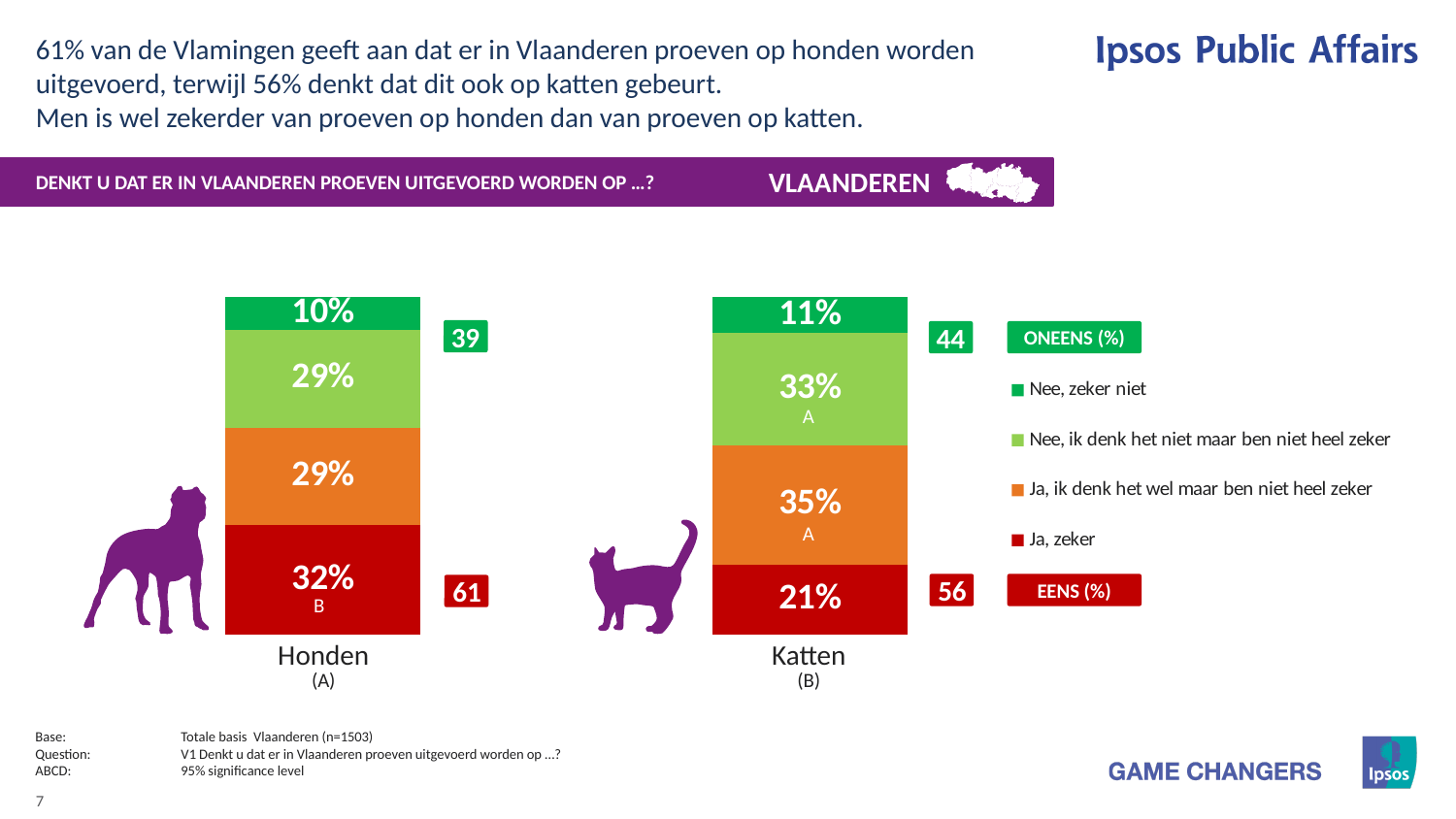
How many series does the legend list? 4 What kind of chart is shown on the slide? Stacked bar chart What is the combined 'ONEENS (%)' total shown for Katten? 44 What is the value of 'Ja, ik denk het wel maar ben niet heel zeker' for Katten? 35% What is the value of 'Ja, zeker' for Honden? 32% How many categories are plotted on the x axis? 2 What is the difference between the 'Ja, zeker' values for Honden and Katten? 11% What is the value of 'Nee, zeker niet' for Katten? 11% Which category has the higher 'Nee, ik denk het niet maar ben niet heel zeker' value, Honden or Katten? Katten What is the value of 'Ja, zeker' for Katten? 21% What is the combined 'EENS (%)' total shown for Honden? 61 Which colour represents 'Ja, zeker' in the legend? Red